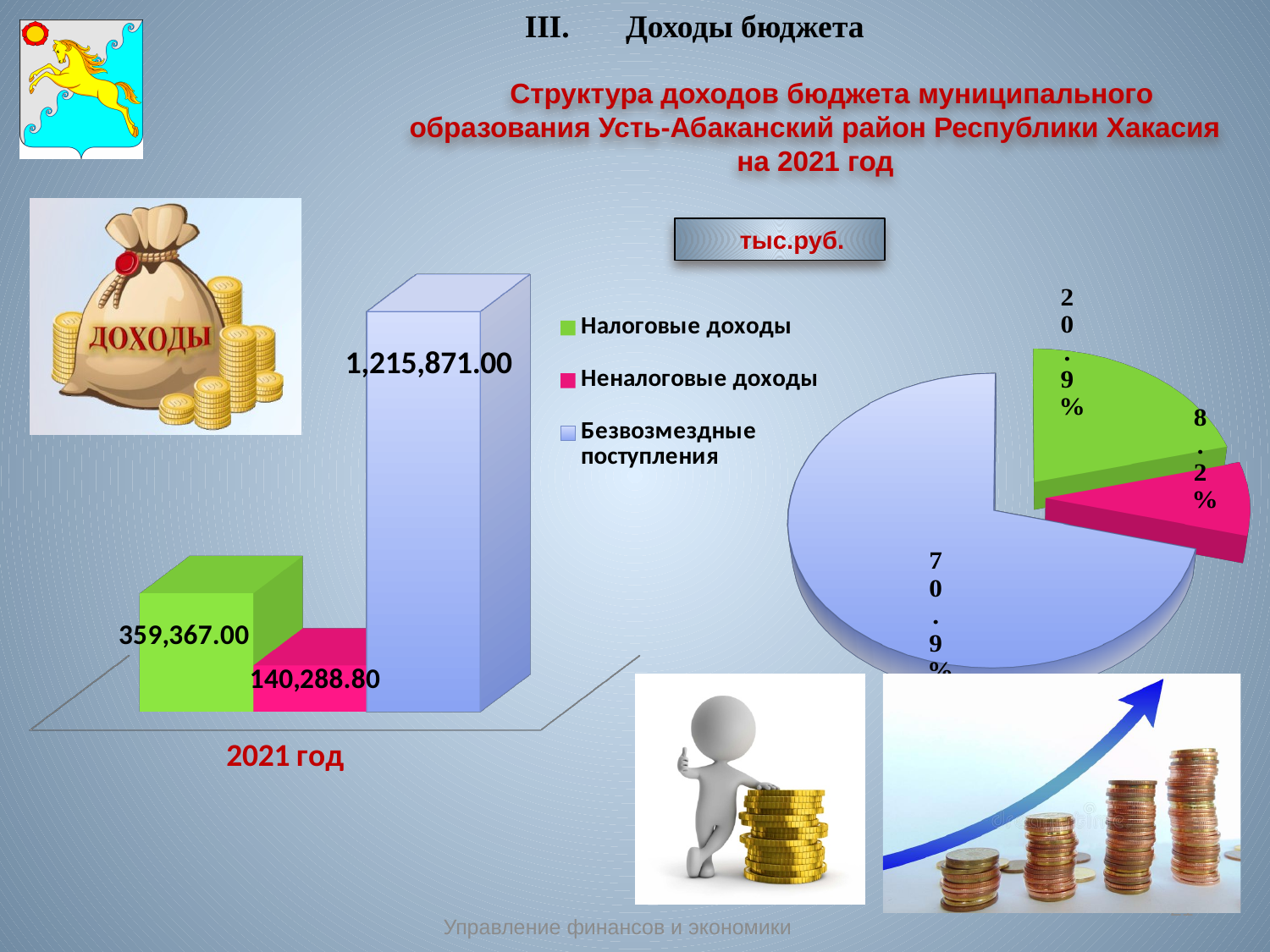
On the bar chart, what is the value for Неналоговые доходы? 140,288.80 On the bar chart, what is the value for Налоговые доходы? 359,367.00 What kind of chart is the chart on the right of the slide? pie chart On the bar chart, which is larger: Налоговые доходы or Неналоговые доходы? Налоговые доходы On the bar chart, what is the difference between Налоговые доходы and Неналоговые доходы? 219,078.20 On the pie chart, what share does the green slice (Налоговые доходы) have? 20.9% On the bar chart, which category has the lowest value? Неналоговые доходы What kind of chart is the chart on the left of the slide? bar chart On the pie chart, what share does the blue slice (Безвозмездные поступления) have? 70.9% On the bar chart, what is the value for Безвозмездные поступления? 1,215,871.00 How many series does the legend of the bar chart list? 3 On the bar chart, which category has the highest value? Безвозмездные поступления